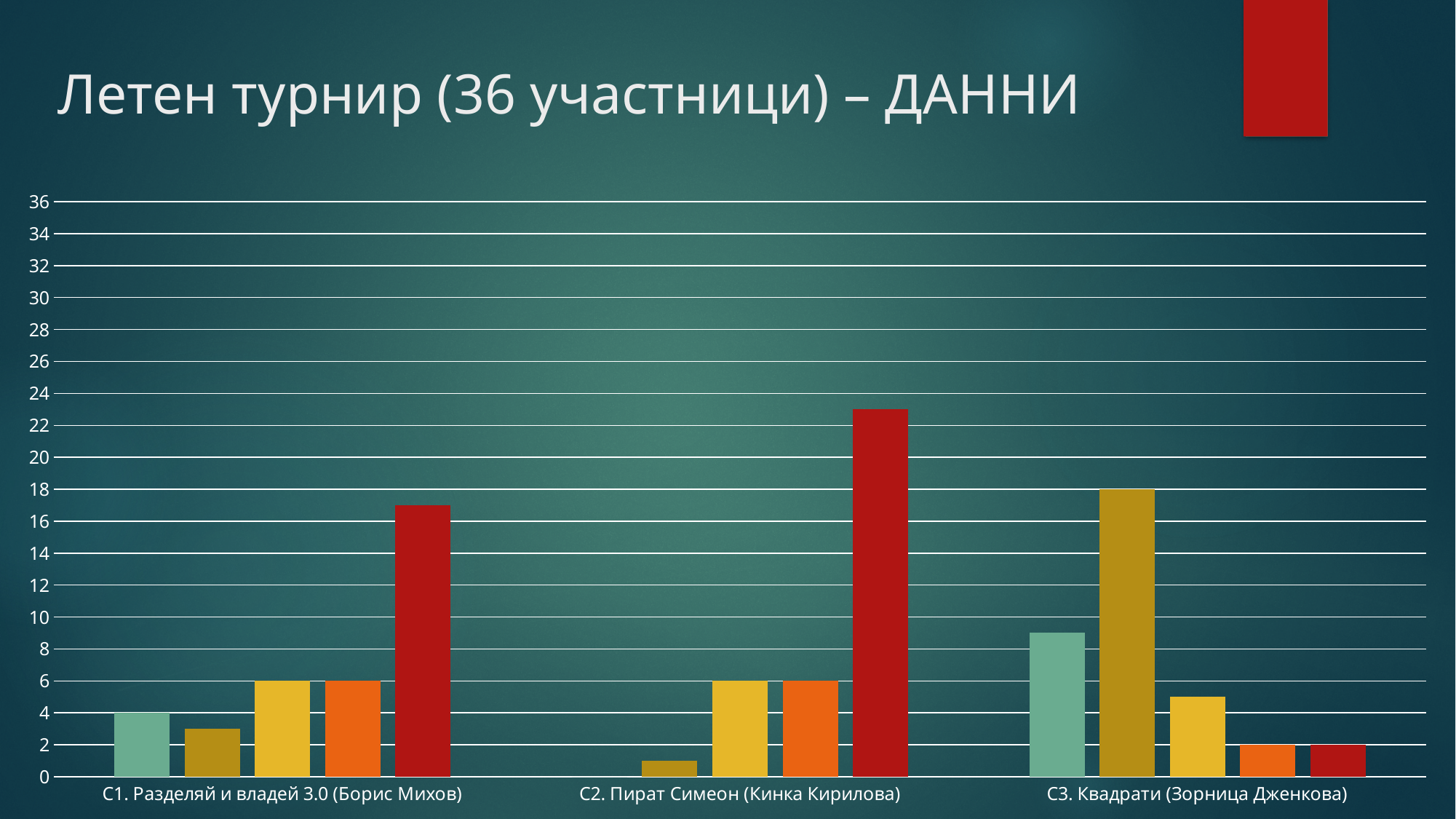
Which category has the tallest red bar? C2. Пират Симеон (Кинка Кирилова) What is the value of the yellow (third) bar for C1. Разделяй и владей 3.0 (Борис Михов)? 6 Is the value of the red bar for C1. Разделяй и владей 3.0 (Борис Михов) greater or less than 20? less How many categories are shown on the x axis of the chart? 3 Is the value of the red bar for C2. Пират Симеон (Кинка Кирилова) greater or less than 20? greater What type of chart is shown on the slide? bar chart What is the difference between the gold (second) bar and the orange (fourth) bar for C3. Квадрати (Зорница Дженкова)? 16 Which is larger: the teal bar for C3. Квадрати (Зорница Дженкова) or the teal bar for C1. Разделяй и владей 3.0 (Борис Михов)? C3. Квадрати (Зорница Дженкова) What is the value of the gold (second) bar for C3. Квадрати (Зорница Дженкова)? 18 Is the value of the gold (second) bar for C2. Пират Симеон (Кинка Кирилова) greater or less than 2? less What is the value of the teal (first) bar for C1. Разделяй и владей 3.0 (Борис Михов)? 4 What is the value of the orange (fourth) bar for C3. Квадрати (Зорница Дженкова)? 2